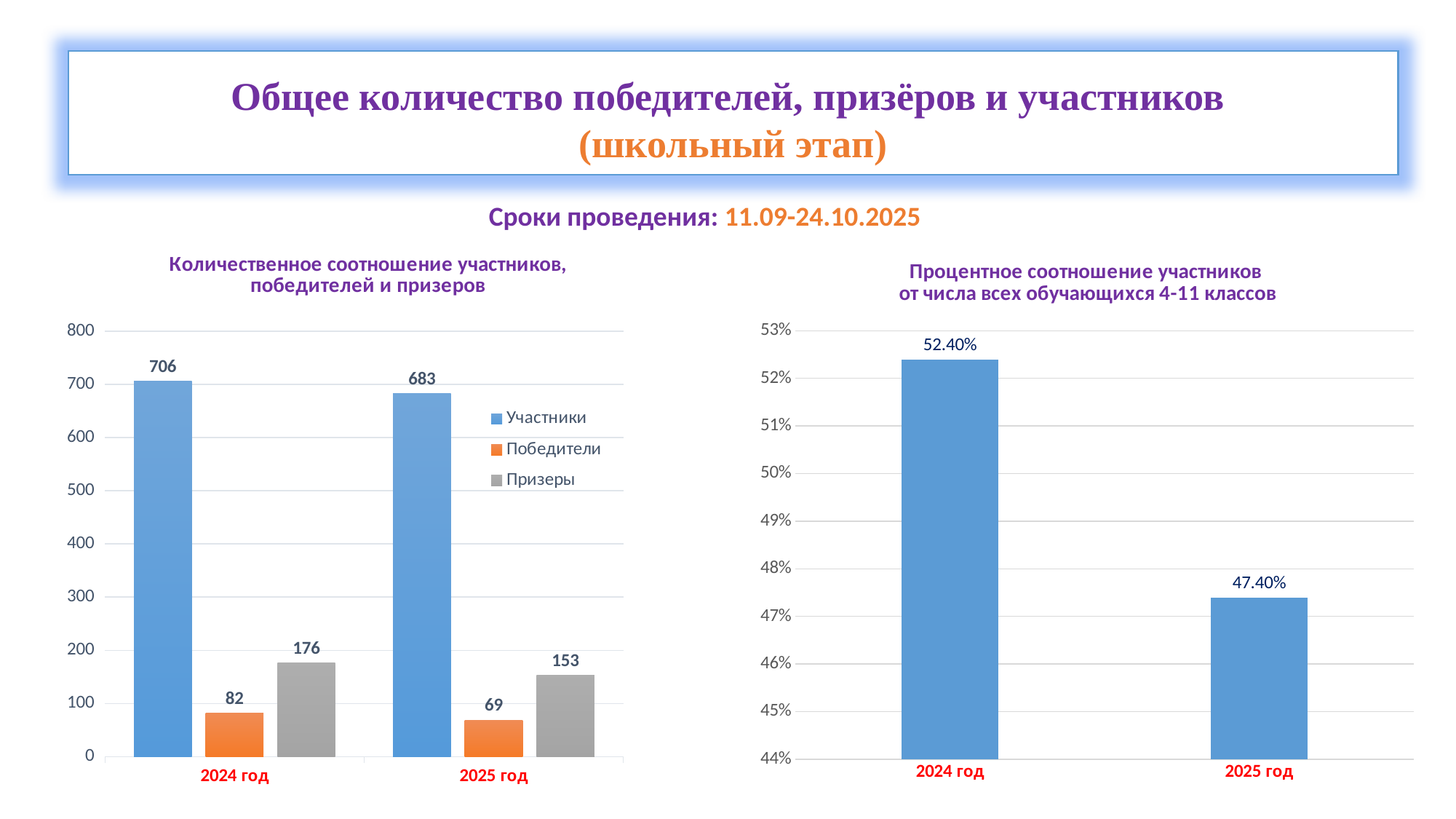
In the left chart (Количественное соотношение участников, победителей и призеров), what is the value for Участники in 2024 год? 706 In the left chart, what is the difference between Участники in 2024 год and 2025 год? 23 In the left chart, which year has the higher value for Призеры? 2024 год In the left chart, how many series does the legend list? 3 In the left chart, what is the difference between Призеры and Победители in 2025 год? 84 In the left chart, which series has the lowest value in 2025 год? Победители In the right chart, what is the value for 2025 год? 47.40% In the left chart, what is the value for Призеры in 2024 год? 176 What kind of chart is the right chart? bar chart In the left chart, what is the value for Победители in 2025 год? 69 In the right chart, do the values rise or fall from 2024 год to 2025 год? fall In the right chart (Процентное соотношение участников от числа всех обучающихся 4-11 классов), what is the value for 2024 год? 52.40%